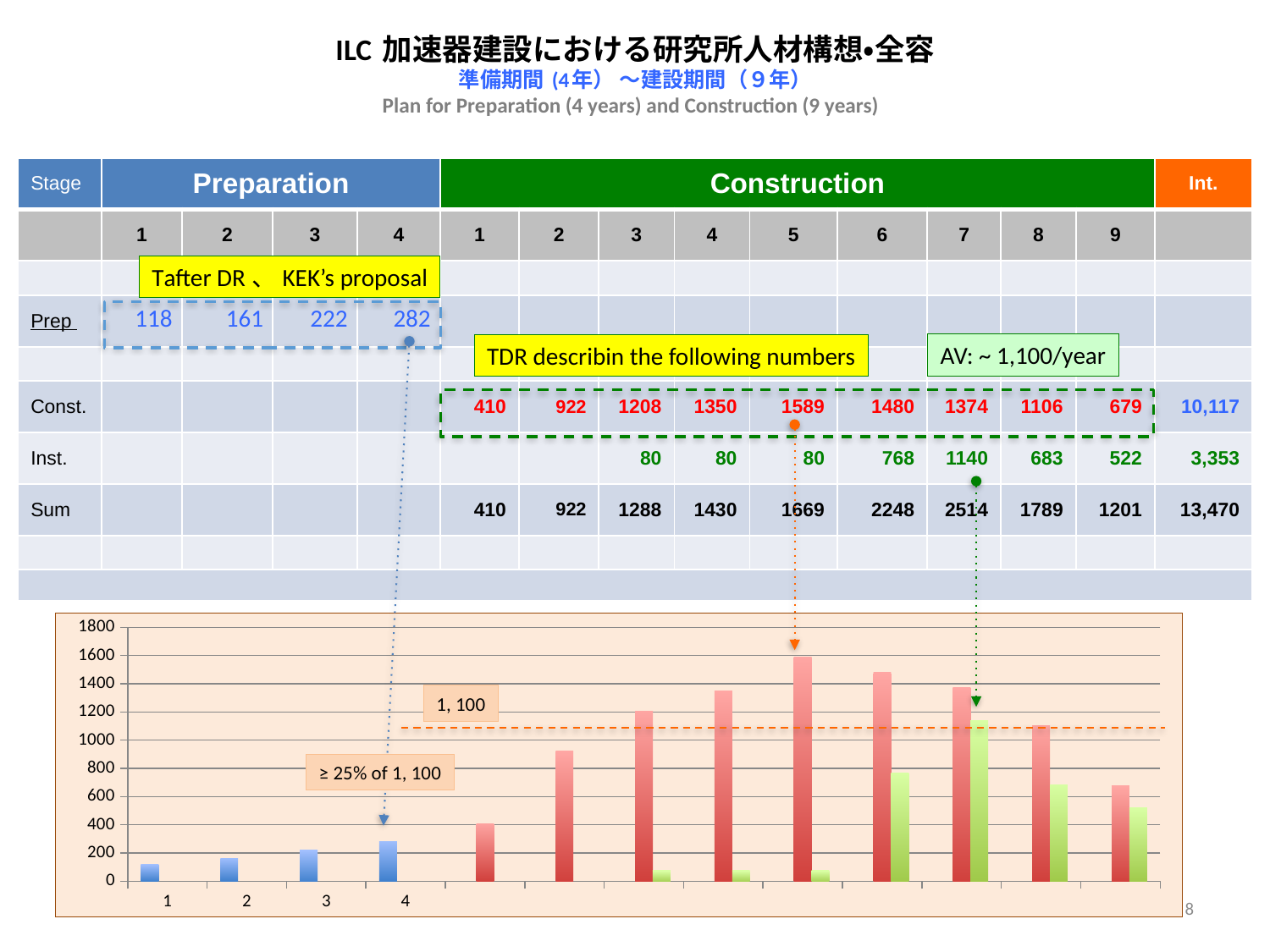
Is the value of the blue bar for category 1 greater or less than 200? less How many red bars are plotted in the chart? 9 Among the blue bars labelled 1 to 4, which category has the lowest bar? 1 Is the tallest red bar greater or less than 1400? greater What value is the dashed horizontal line in the chart labelled with? 1, 100 What is the highest tick value shown on the chart's y axis? 1800 How many green bars are plotted in the chart? 7 Do the blue bars rise or fall from category 1 to category 4? rise What kind of chart is shown at the bottom of the slide? bar chart Is the value of the blue bar for category 4 greater or less than 200? greater Among the blue bars labelled 1 to 4, which category has the highest bar? 4 How many blue bars are plotted in the chart? 4